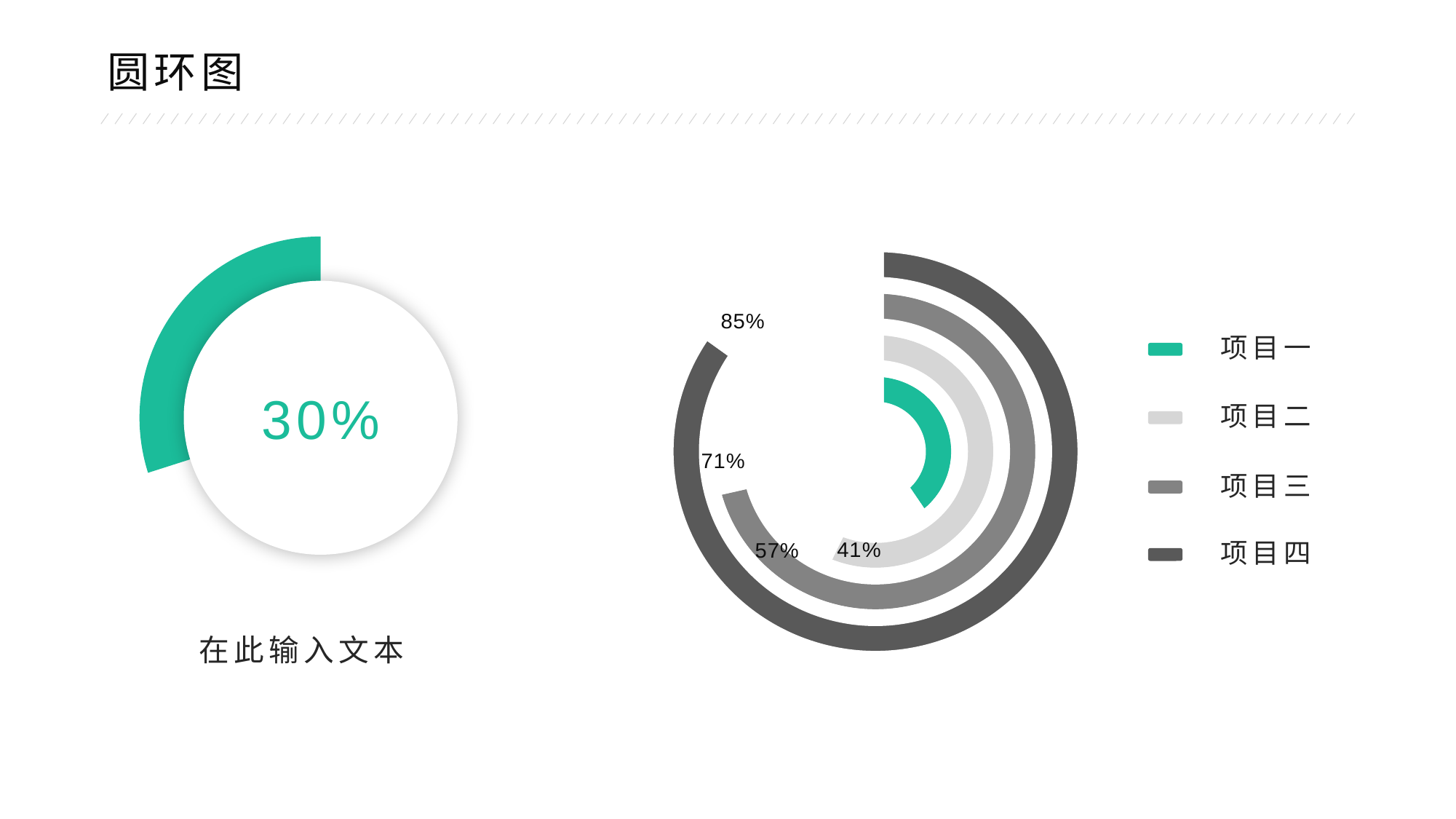
On the right chart, what colour is the ring for 项目一? Green On the right chart, what is the value for 项目一? 41% On the right chart, which is larger, the value for 项目二 or the value for 项目三? 项目三 On the right chart, what is the value for 项目四? 85% On the right chart, what is the value for 项目三? 71% On the right chart, what is the value for 项目二? 57% On the left chart, what percentage is shown in the centre of the ring? 30% On the right chart, which series has the highest value? 项目四 On the right chart, what is the difference between the values for 项目四 and 项目一? 44% What kind of chart is the right chart? Doughnut chart How many series does the legend of the right chart list? 4 On the right chart, which series has the lowest value? 项目一